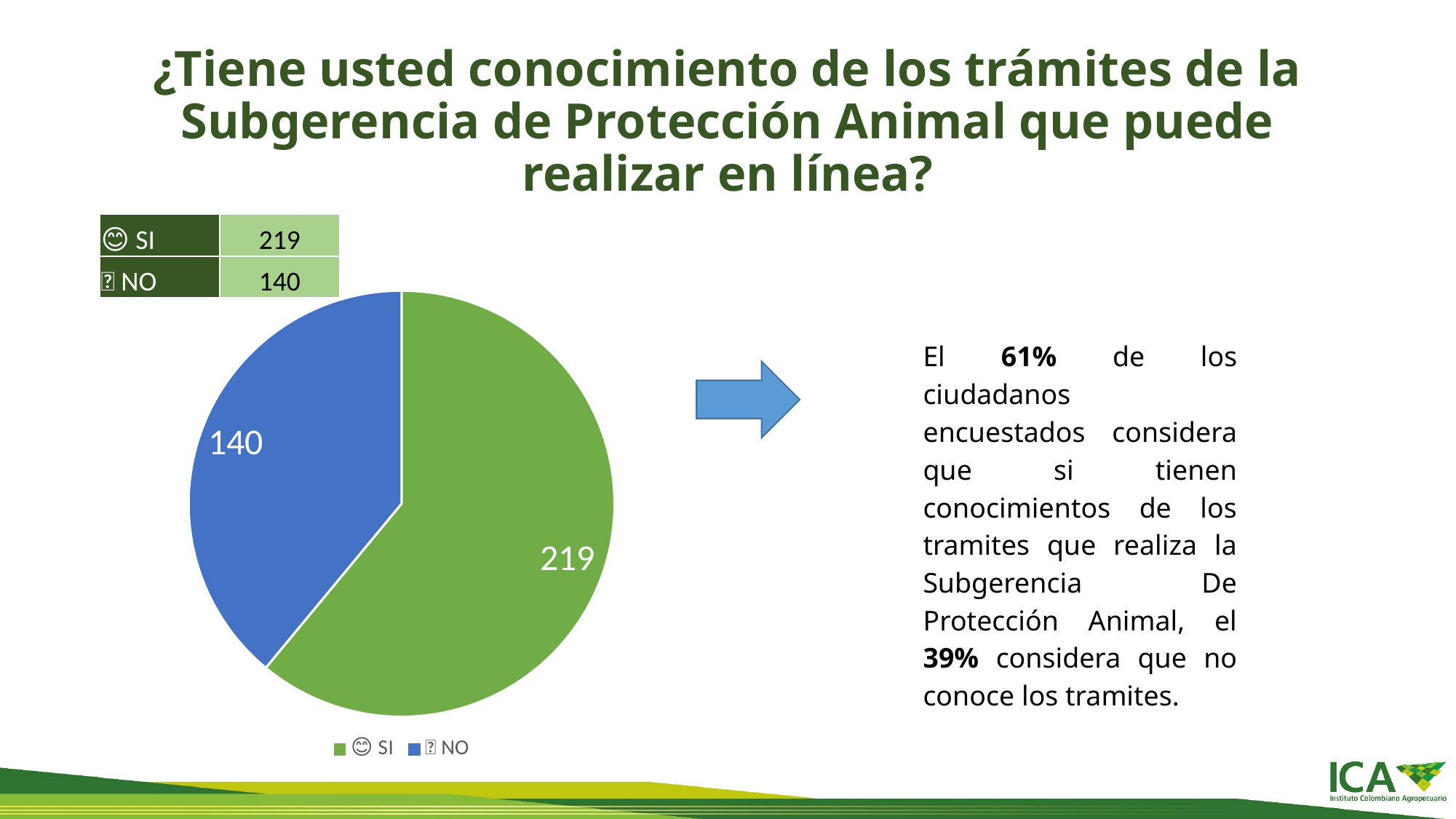
What colour is the SI slice in the pie chart? Green Which category has the largest slice in the pie chart? SI Which is larger in the pie chart, SI or NO? SI What is the value for SI in the pie chart? 219 What is the difference between the SI and NO values in the pie chart? 79 What colour is the NO slice in the pie chart? Blue How many slices does the pie chart have? 2 Which category has the smallest slice in the pie chart? NO What is the total of the two values shown in the pie chart? 359 What kind of chart is shown on the slide? Pie chart What is the value for NO in the pie chart? 140